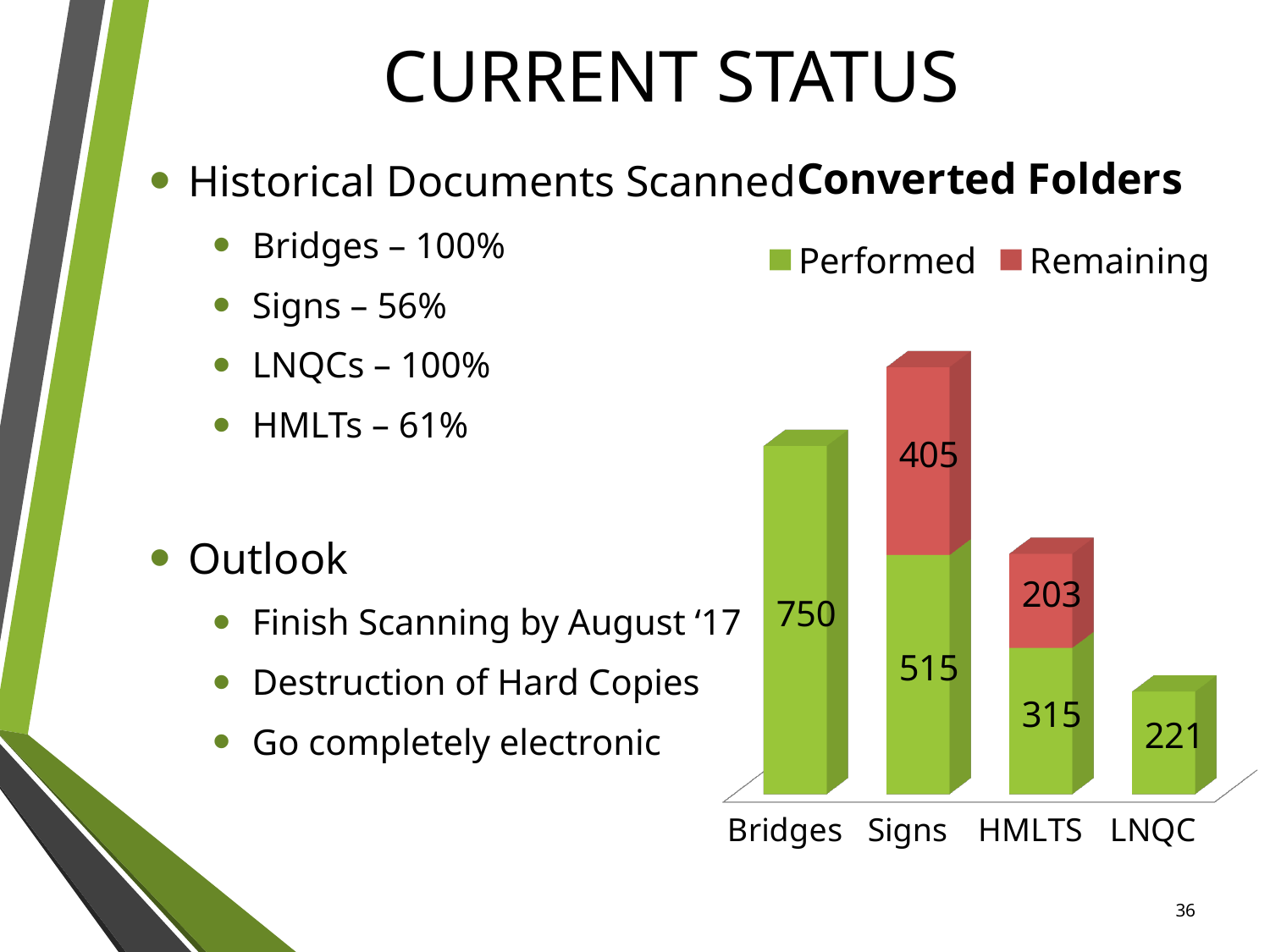
What is the difference between the Performed values for Signs and HMLTS? 200 What is the Remaining value for Signs? 405 What is the total of the stacked bar for Signs? 920 Which category has the highest Performed value? Bridges What is the Performed value for Bridges? 750 Which category has the lowest Performed value? LNQC What is the Performed value for HMLTS? 315 How many categories are shown on the x axis? 4 What is the Performed value for LNQC? 221 Which is larger, the Remaining value for Signs or the Remaining value for HMLTS? Signs How many series does the legend list? 2 What is the total of the stacked bar for HMLTS? 518